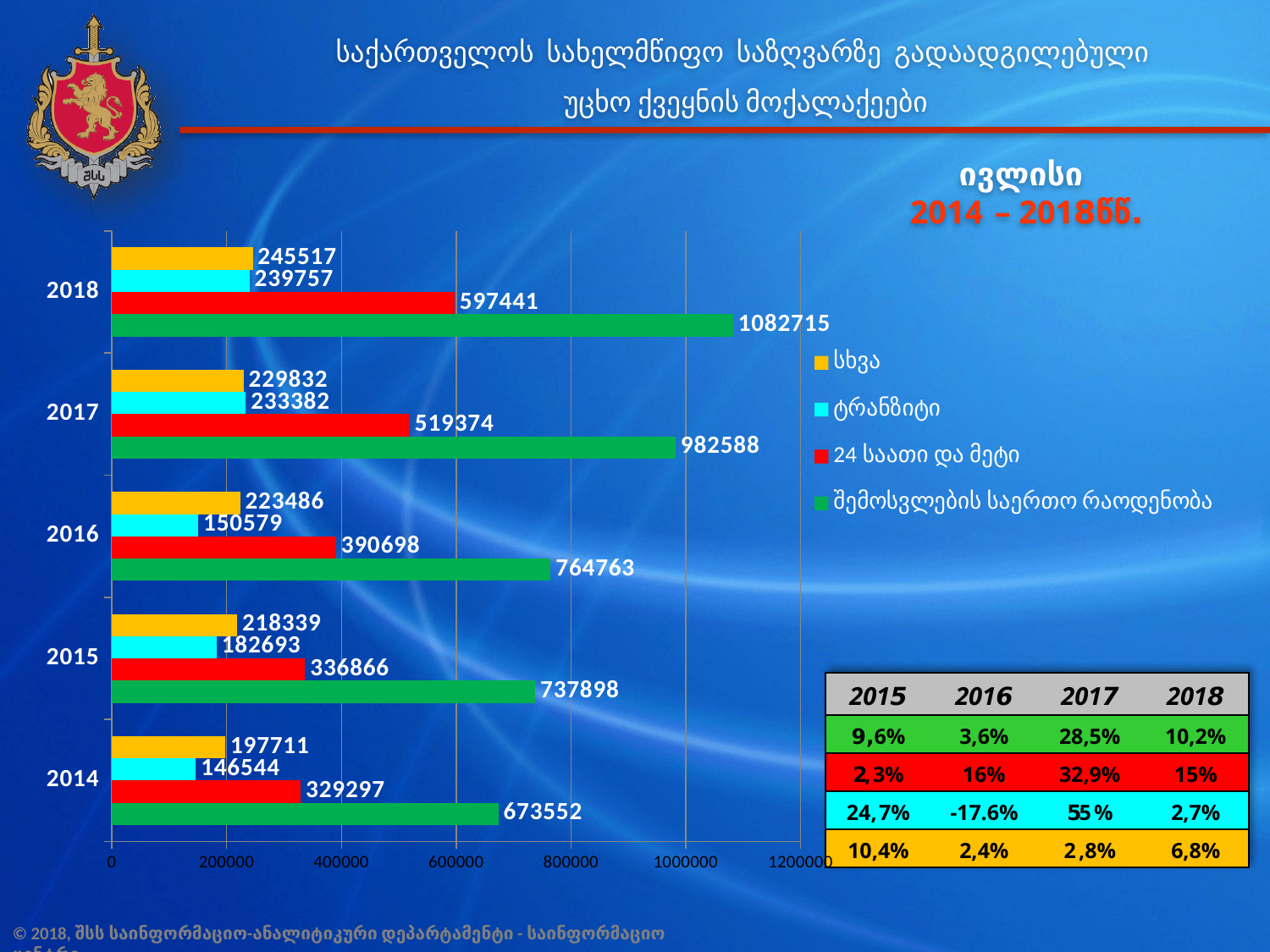
How many series does the legend list? 4 Is the value of the green bar for 2016 greater or less than 600000? greater What is the difference between the green bar values for 2018 and 2017? 100127 What kind of chart is shown on the slide? bar chart Which year has the highest value for the green series (შემოსვლების საერთო რაოდენობა)? 2018 For 2017, which is larger: the yellow bar (სხვა) or the cyan bar (ტრანზიტი)? ტრანზიტი (cyan) What is the value of the green bar (შემოსვლების საერთო რაოდენობა) for 2018? 1082715 What is the value of the cyan bar (ტრანზიტი) for 2014? 146544 What is the value of the red bar (24 საათი და მეტი) for 2016? 390698 Which year has the lowest value for the yellow series (სხვა)? 2014 What is the difference between the red bar values for 2015 and 2014? 7569 How many years are shown on the chart? 5